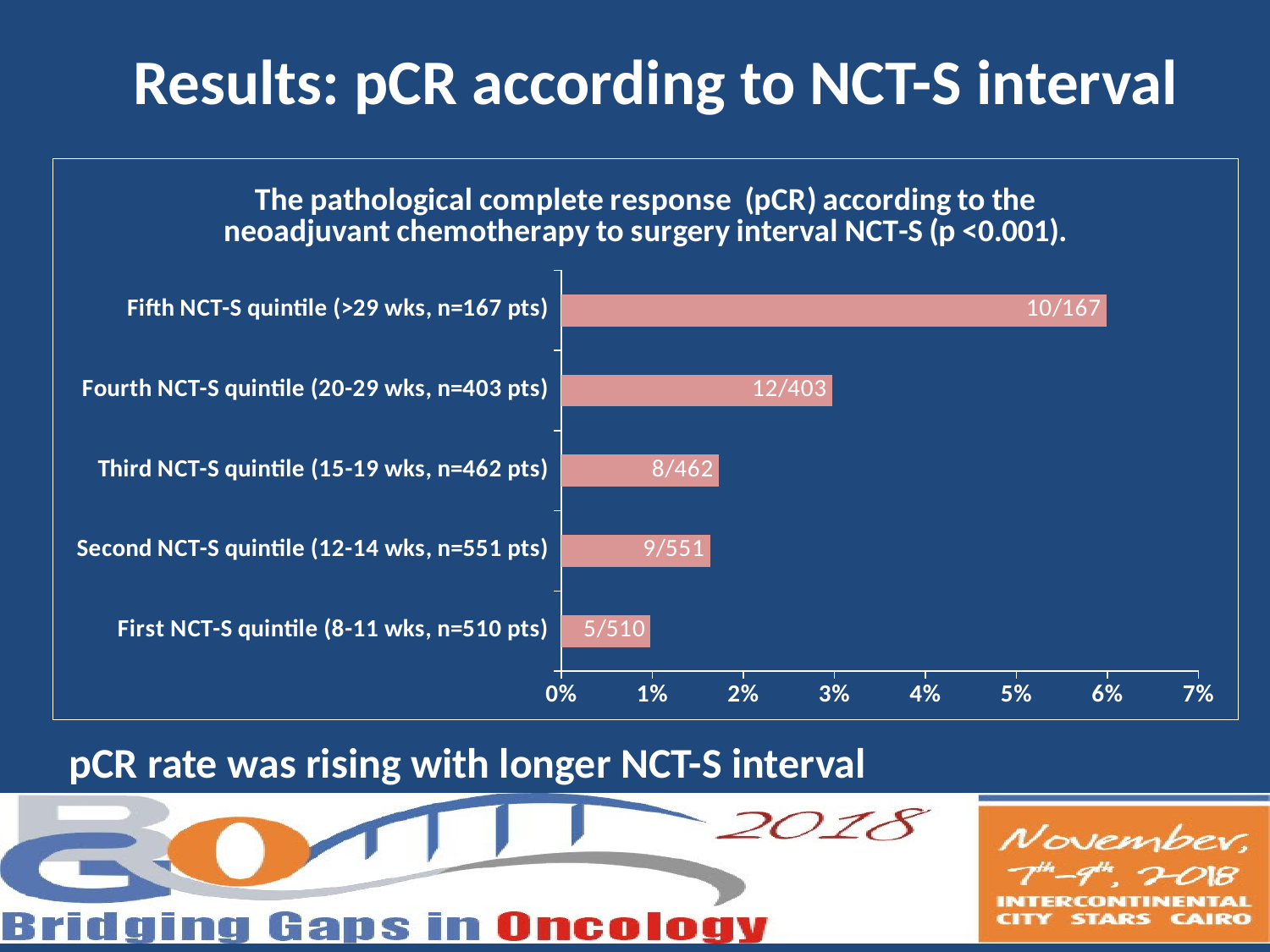
Which has the larger pCR rate: the Fourth NCT-S quintile or the Third NCT-S quintile? Fourth NCT-S quintile Which NCT-S quintile has the highest pCR rate in the chart? Fifth NCT-S quintile (>29 wks, n=167 pts) Which NCT-S quintile has the lowest pCR rate in the chart? First NCT-S quintile (8-11 wks, n=510 pts) What kind of chart is shown on the slide? Bar chart What data label is shown on the bar for the Third NCT-S quintile (15-19 wks)? 8/462 Is the pCR rate for the Fifth NCT-S quintile greater or less than 5%? greater What data label is shown on the bar for the Fourth NCT-S quintile (20-29 wks)? 12/403 Is the pCR rate for the Fourth NCT-S quintile greater or less than 4%? less What data label is shown on the bar for the Fifth NCT-S quintile (>29 wks)? 10/167 How many NCT-S quintile categories are plotted in the chart? 5 What data label is shown on the bar for the First NCT-S quintile (8-11 wks)? 5/510 What p-value is stated in the chart title? p <0.001